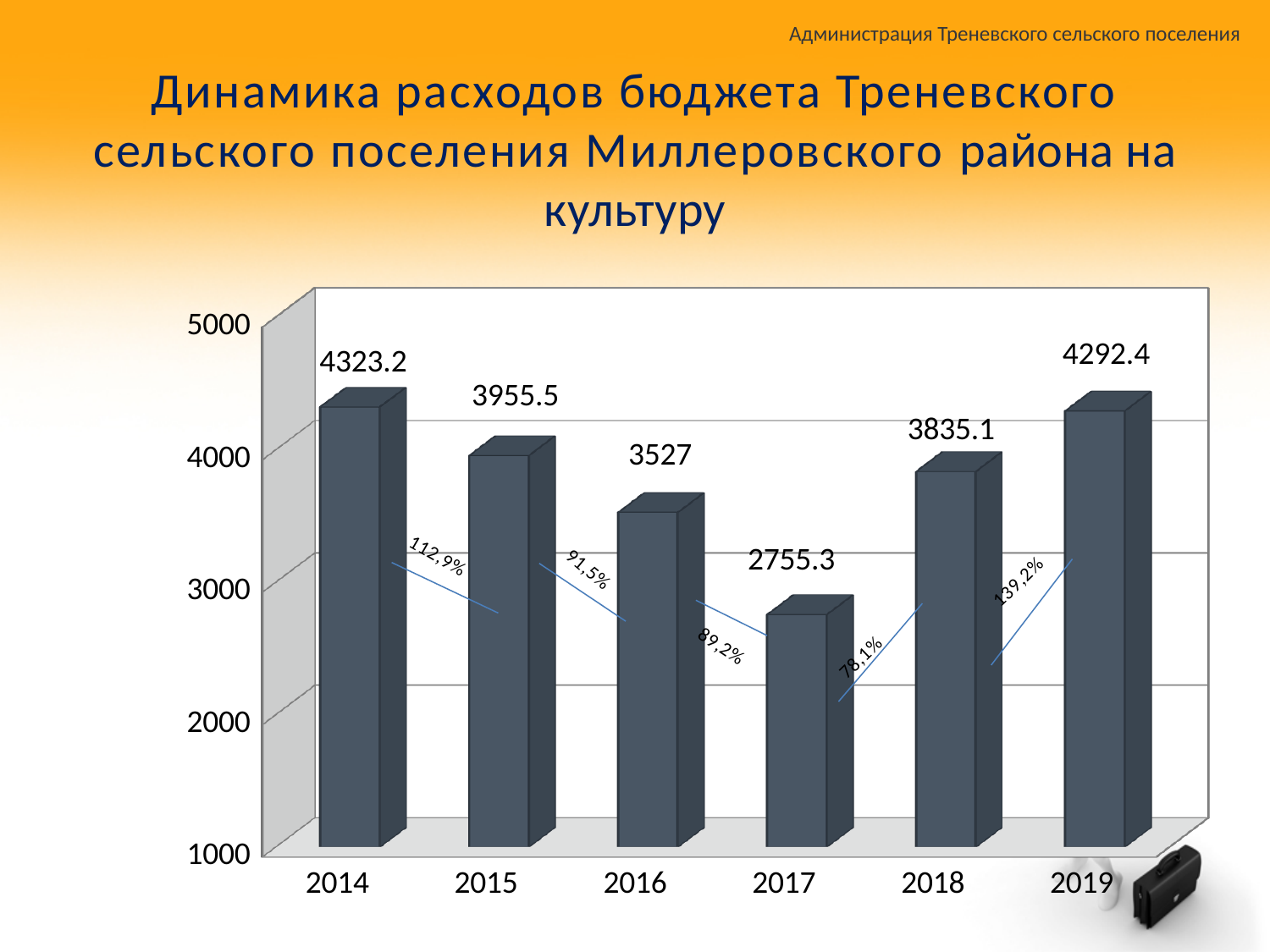
Which year has the lowest value? 2017 Do the values rise or fall from 2014 to 2017? fall Is the value for 2017 greater or less than 3000? less What is the value for 2019? 4292.4 Which year has the highest value? 2014 What is the value for 2014? 4323.2 Which is larger, the value for 2015 or the value for 2018? 2015 What kind of chart is shown on the slide? bar chart How many years are shown on the x axis? 6 What is the value for 2017? 2755.3 What is the difference between the values for 2015 and 2016? 428.5 What is the difference between the values for 2018 and 2017? 1079.8